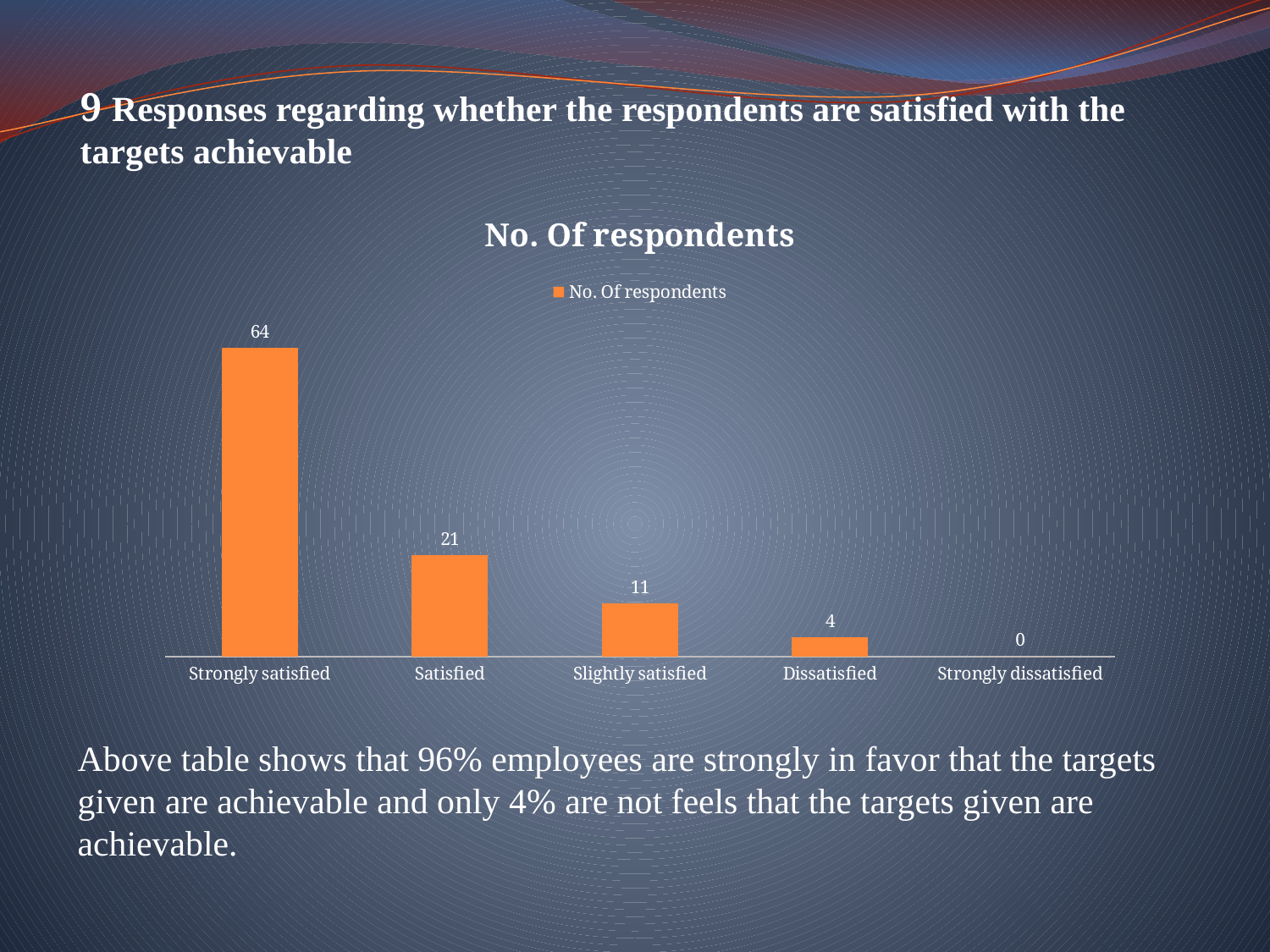
How many categories are shown on the x axis? 5 What kind of chart is shown on the slide? Bar chart What is the number of respondents for Strongly satisfied? 64 Which category has the highest number of respondents? Strongly satisfied Which has more respondents, Slightly satisfied or Dissatisfied? Slightly satisfied What is the number of respondents for Strongly dissatisfied? 0 What is the difference between the number of respondents for Strongly satisfied and Satisfied? 43 What is the number of respondents for Dissatisfied? 4 What is the title of the chart? No. Of respondents Which category has the lowest number of respondents? Strongly dissatisfied What is the number of respondents for Satisfied? 21 What is the number of respondents for Slightly satisfied? 11